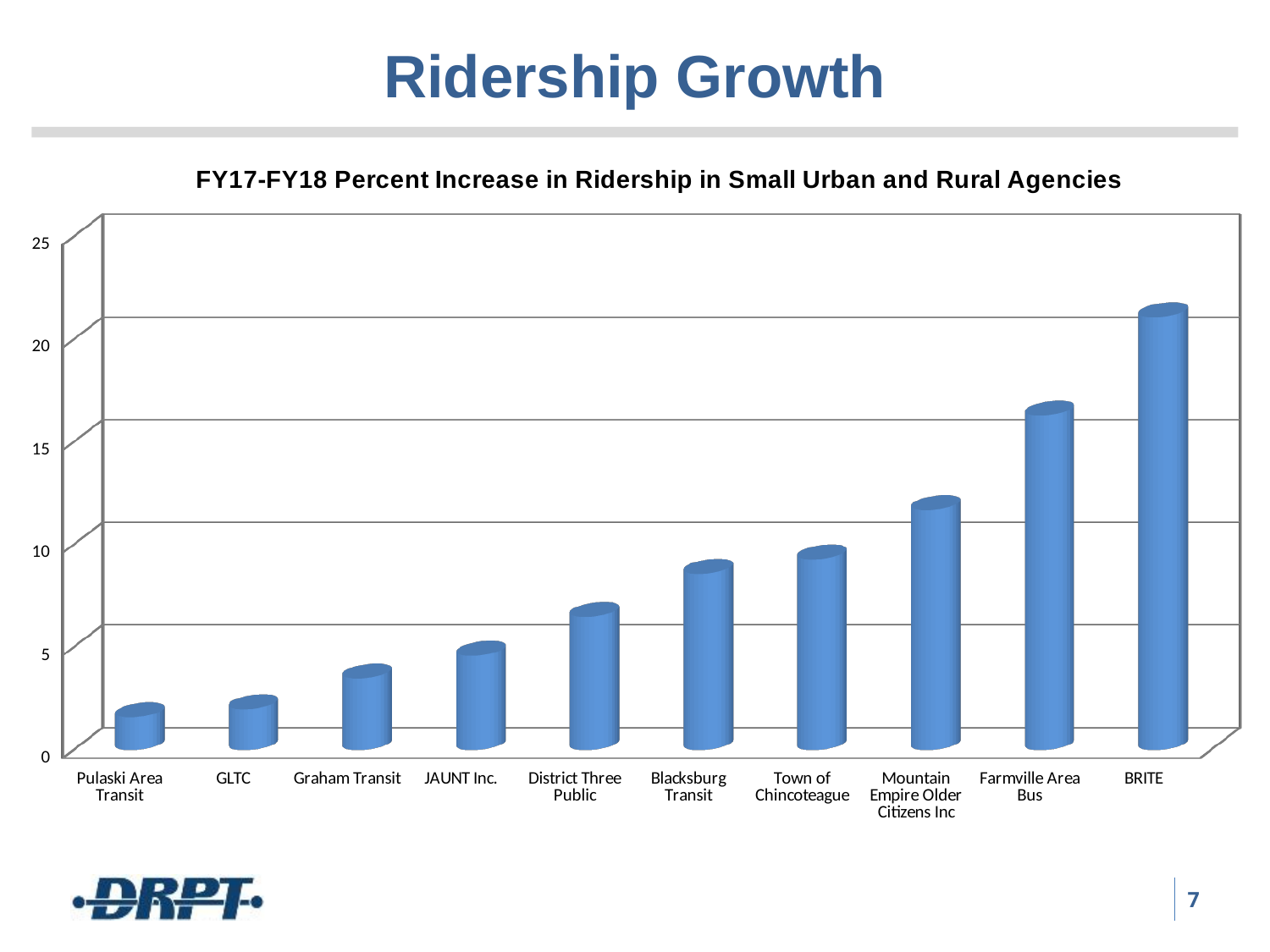
Is the value for District Three Public greater or less than 5? greater Is the value for BRITE greater or less than 15? greater Which has the larger percent increase, Farmville Area Bus or Mountain Empire Older Citizens Inc? Farmville Area Bus Which agency has the highest percent increase in ridership? BRITE Is the value for Pulaski Area Transit greater or less than 5? less Which agency has the lowest percent increase in ridership? Pulaski Area Transit How many agencies are shown on the x axis of the chart? 10 What is the title of the chart? FY17-FY18 Percent Increase in Ridership in Small Urban and Rural Agencies What kind of chart is shown on the slide? bar chart Do the values rise or fall moving from left to right along the x axis? rise